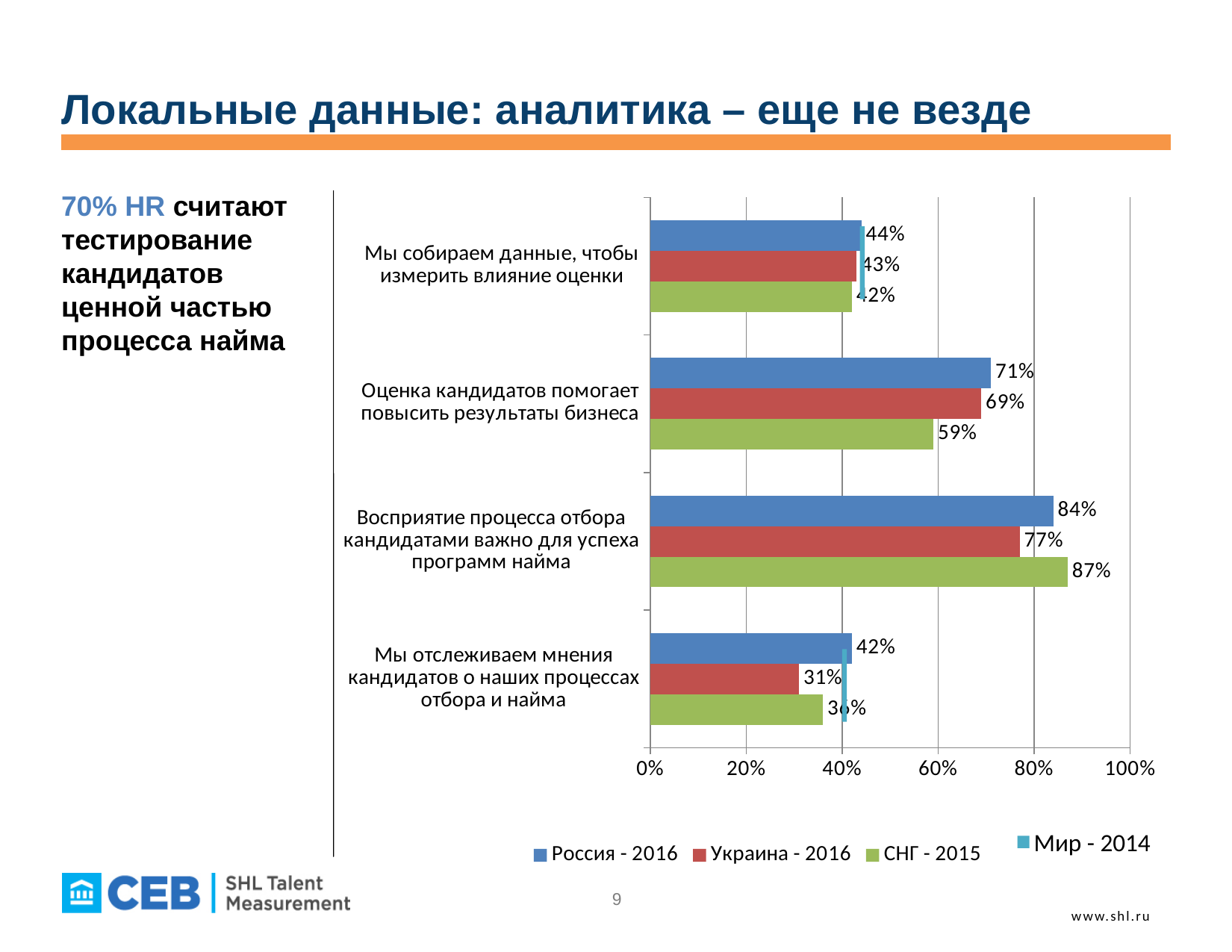
What is the value for СНГ - 2015 in the category "Восприятие процесса отбора кандидатами важно для успеха программ найма"? 87% What is the value for Украина - 2016 in the category "Мы собираем данные, чтобы измерить влияние оценки"? 43% How many series does the chart legend list? 4 What is the value for Украина - 2016 in the category "Мы отслеживаем мнения кандидатов о наших процессах отбора и найма"? 31% What is the difference between the Россия - 2016 and СНГ - 2015 values in the category "Оценка кандидатов помогает повысить результаты бизнеса"? 12% What is the value for Россия - 2016 in the category "Оценка кандидатов помогает повысить результаты бизнеса"? 71% What kind of chart is shown on the slide? bar chart Which series is shown in green in the chart legend? СНГ - 2015 How many categories are shown on the chart? 4 In which category is the Россия - 2016 value highest? Восприятие процесса отбора кандидатами важно для успеха программ найма In which category is the Украина - 2016 value lowest? Мы отслеживаем мнения кандидатов о наших процессах отбора и найма In the category "Восприятие процесса отбора кандидатами важно для успеха программ найма", which is larger: Россия - 2016 or Украина - 2016? Россия - 2016